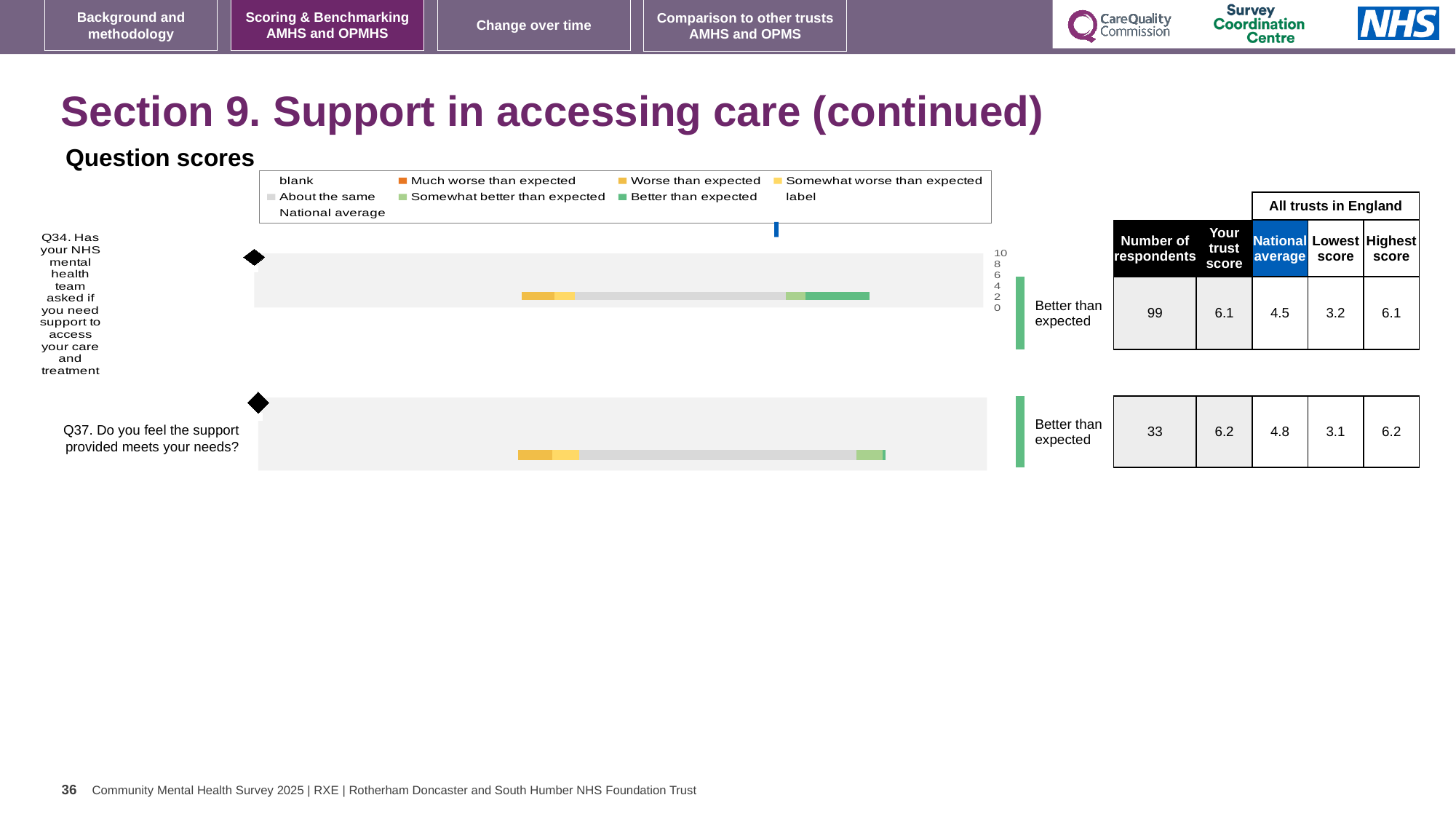
How many questions (bars) are plotted in the Question scores chart? 2 According to the table beside the chart, how many respondents answered Q34? 99 What benchmark label is shown next to the bar for Q37? Better than expected According to the table beside the chart, what is the highest score among all trusts in England for Q34? 6.1 According to the table beside the chart, what is the national average for Q34? 4.5 In the chart legend, which category is shown in orange? Much worse than expected What is the difference between the trust score and the national average for Q34 in the table beside the chart? 1.6 What kind of chart is used to show the question scores on this slide? bar chart Which question has the higher trust score in the table beside the chart, Q34 or Q37? Q37 What is the title of the chart on this slide? Question scores According to the table beside the chart, what is the trust score for Q37 (Do you feel the support provided meets your needs?)? 6.2 According to the table beside the chart, what is the lowest score among all trusts in England for Q37? 3.1